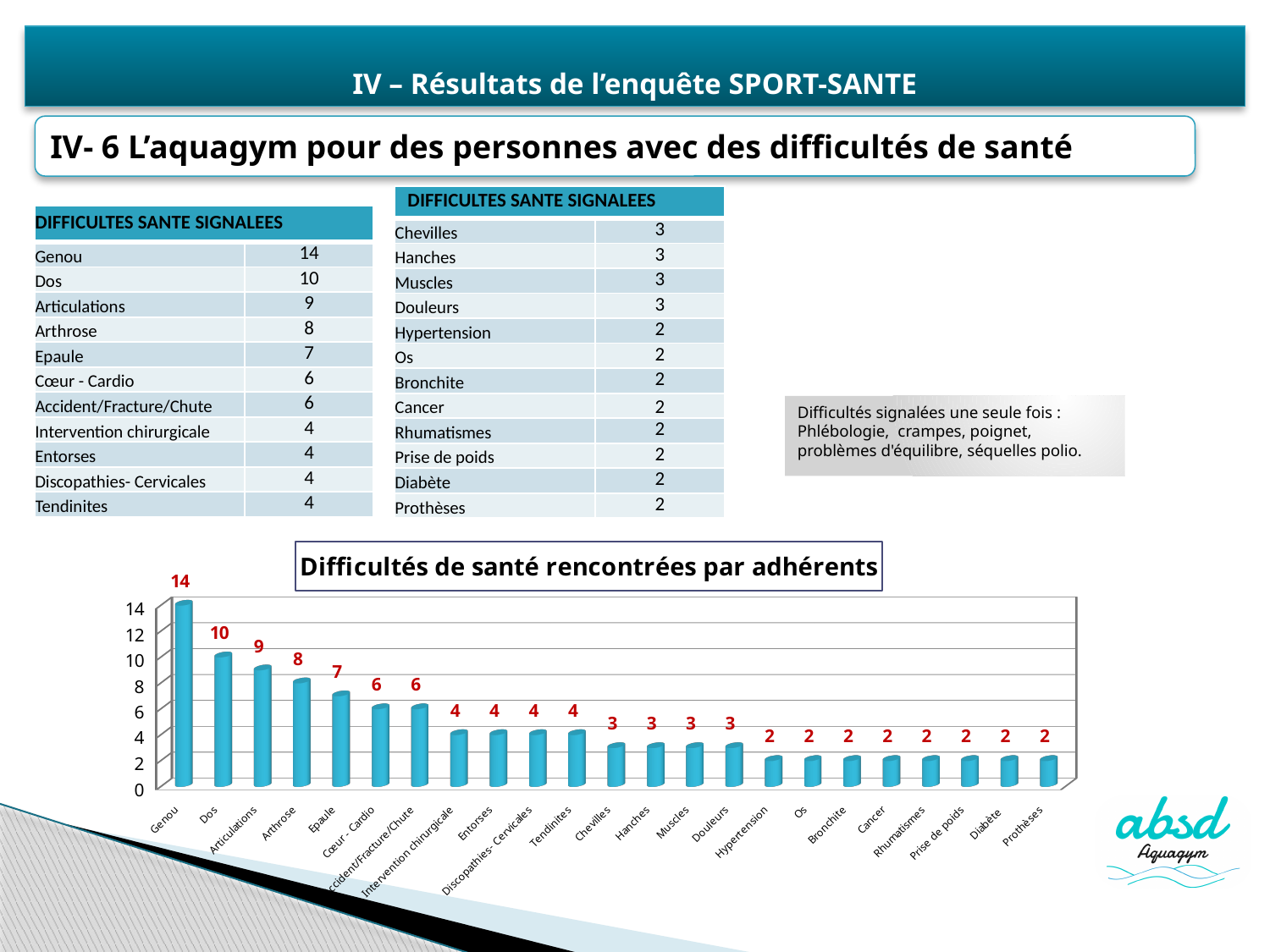
Which is larger, the value for Dos or the value for Arthrose? Dos Do the values rise or fall from left to right along the x axis? Fall Which category has the highest value in the chart? Genou What is the value for Arthrose in the chart? 8 What is the value for Chevilles in the chart? 3 What is the difference between the values for Genou and Dos? 4 What kind of chart is shown on the slide? Bar chart What is the difference between the values for Articulations and Epaule? 2 What is the value for Genou in the chart? 14 Is the value for Epaule greater or less than 6? greater What is the title of the chart? Difficultés de santé rencontrées par adhérents How many categories are shown on the x axis of the chart? 23